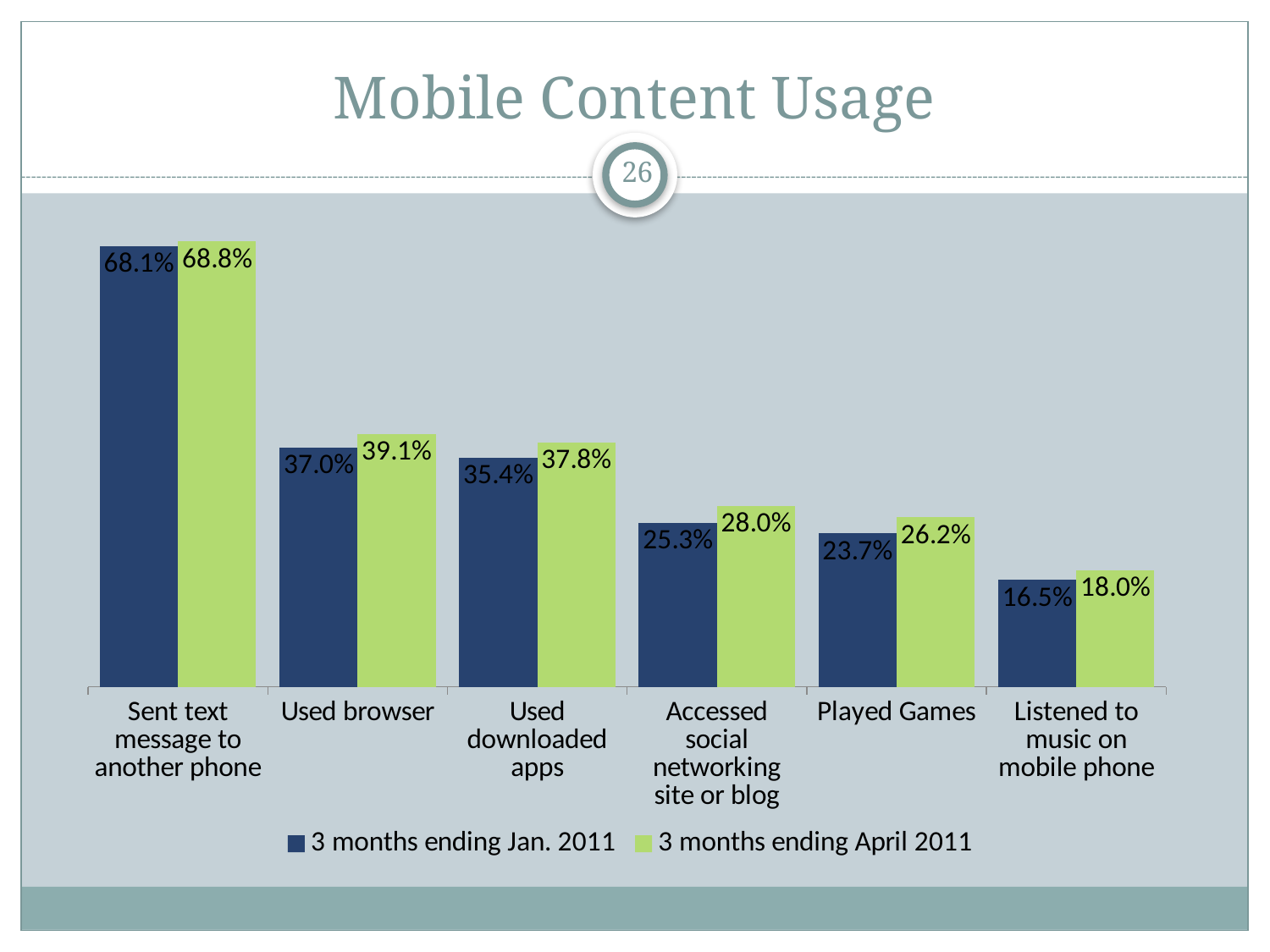
How many series does the legend list? 2 How many categories are shown on the x axis? 6 What is the value for 'Listened to music on mobile phone' in the 3 months ending April 2011 series? 18.0% What is the title of the chart? Mobile Content Usage What kind of chart is shown on the slide? Bar chart Which is larger: the Jan. 2011 value for 'Used browser' or the Jan. 2011 value for 'Used downloaded apps'? Used browser Which category has the highest value in the 3 months ending Jan. 2011 series? Sent text message to another phone What is the difference between the April 2011 and Jan. 2011 values for 'Accessed social networking site or blog'? 2.7% Which category has the lowest value in the 3 months ending April 2011 series? Listened to music on mobile phone What is the value for 'Used browser' in the 3 months ending April 2011 series? 39.1% What is the value for 'Played Games' in the 3 months ending Jan. 2011 series? 23.7% Do the values in the 3 months ending April 2011 series rise or fall from left to right along the x axis? Fall